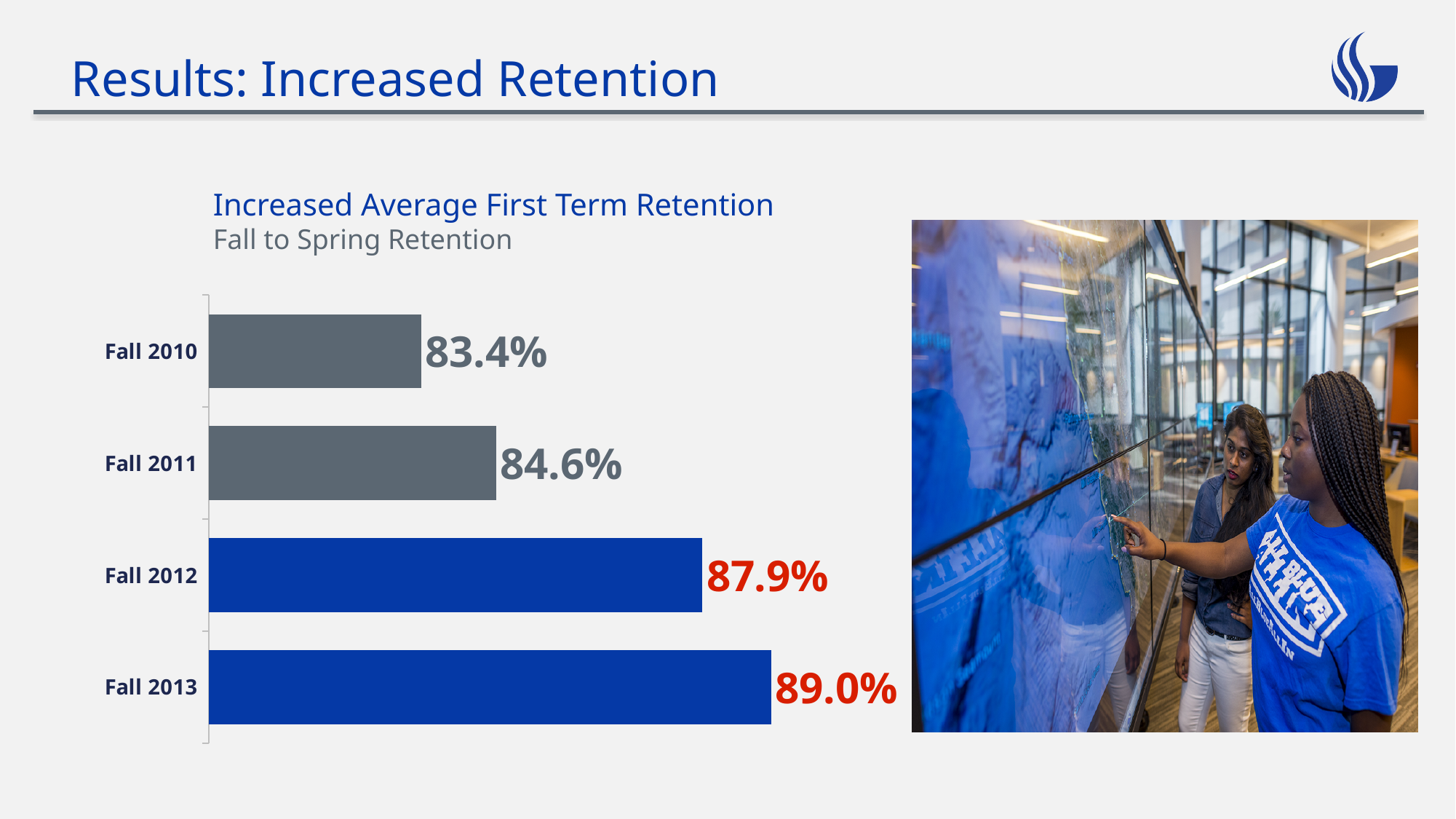
What is the Fall to Spring retention value for Fall 2013? 89.0% Which term has the highest retention value? Fall 2013 What is the Fall to Spring retention value for Fall 2010? 83.4% Do the retention values rise or fall from Fall 2010 to Fall 2013? Rise What is the difference in retention between Fall 2012 and Fall 2011? 3.3% Which has a higher retention value, Fall 2011 or Fall 2012? Fall 2012 How many terms are shown in the chart? 4 Which term has the lowest retention value? Fall 2010 What is the difference in retention between Fall 2013 and Fall 2010? 5.6% What kind of chart is shown on the slide? Bar chart What is the Fall to Spring retention value for Fall 2012? 87.9% What is the Fall to Spring retention value for Fall 2011? 84.6%